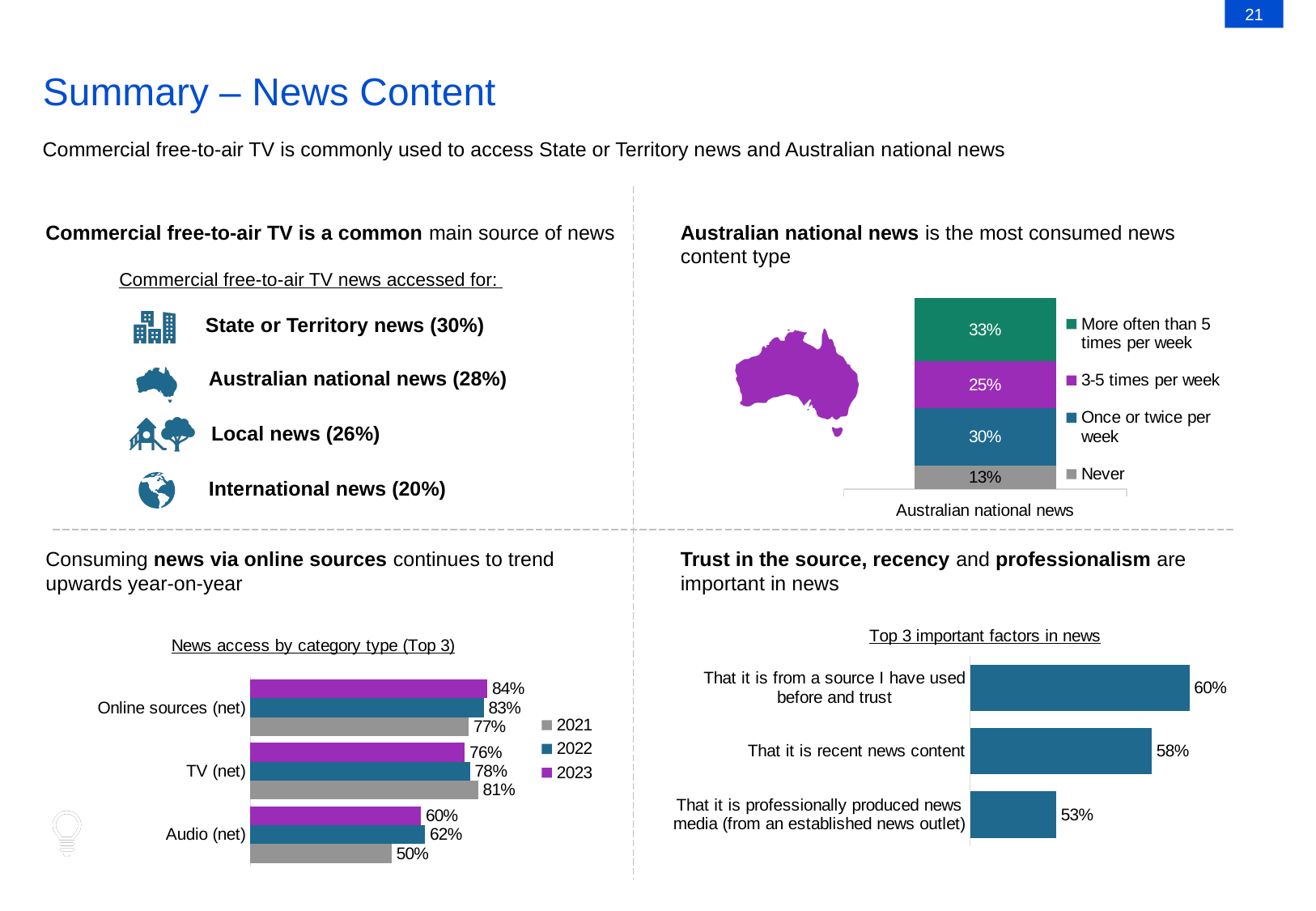
What type of chart is 'Top 3 important factors in news'? Bar chart In the 'Australian national news' stacked bar chart, what is the difference between the '3-5 times per week' and 'Never' segments? 12% In the 'Australian national news' stacked bar chart, how many segments does the legend list? 4 In the 'Top 3 important factors in news' chart, what is the value for 'That it is recent news content'? 58% In the 'News access by category type (Top 3)' chart, which category has the lowest 2021 value? Audio (net) In the 'News access by category type (Top 3)' chart, what is the difference between the 2023 and 2021 values for Online sources (net)? 7% In the 'Australian national news' stacked bar chart, what percentage consume Australian national news more often than 5 times per week? 33% In the 'News access by category type (Top 3)' chart, how many years does the legend list? 3 In the 'News access by category type (Top 3)' chart, what is the 2023 value for Online sources (net)? 84% In the 'News access by category type (Top 3)' chart, which is larger for TV (net): the 2022 value or the 2023 value? 2022 In the 'Australian national news' stacked bar chart, what percentage never consume Australian national news? 13% In the 'News access by category type (Top 3)' chart, what is the 2021 value for Audio (net)? 50%